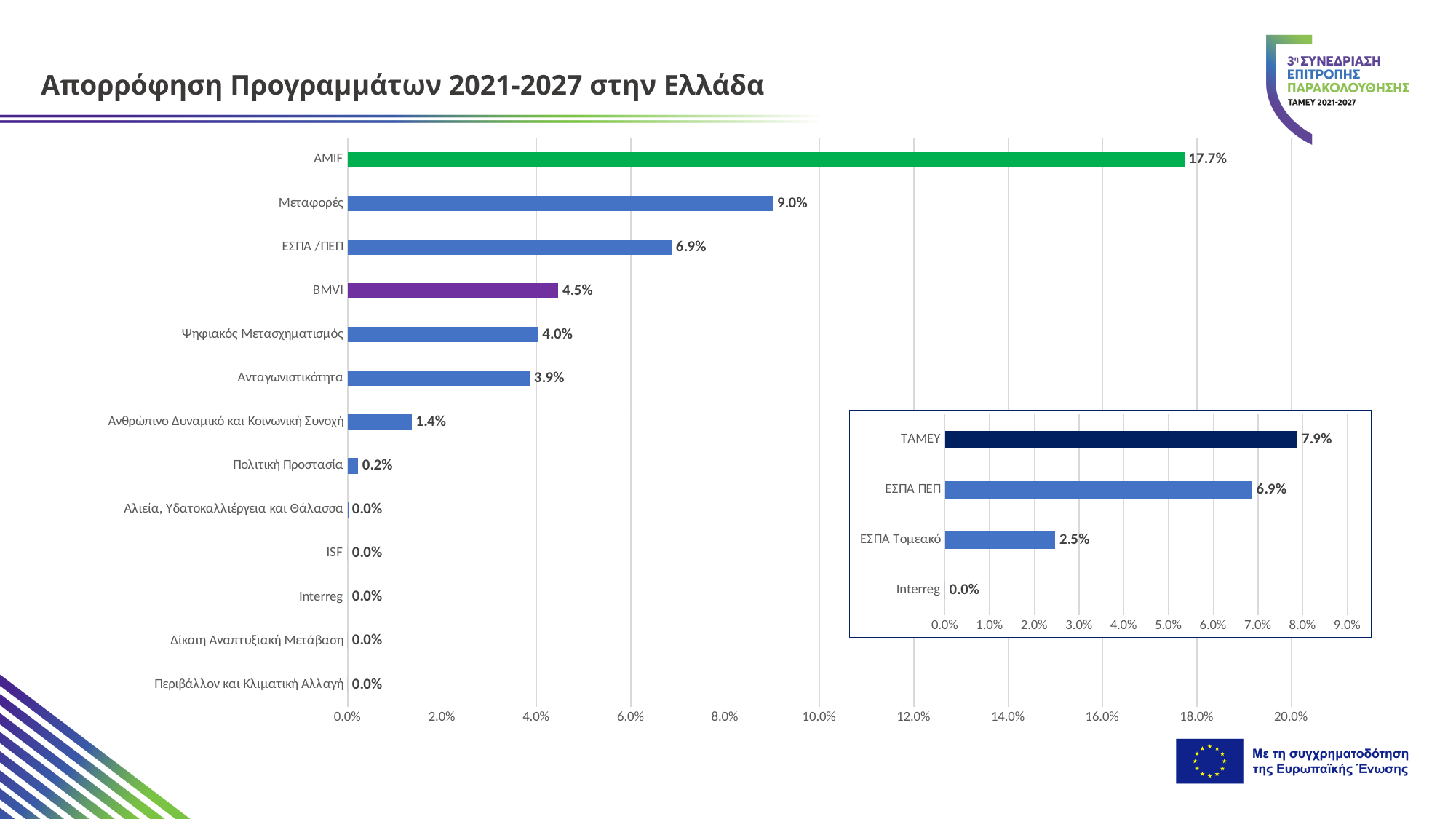
In the small inset chart on the right, what is the value for ΤΑΜΕΥ? 7.9% In the small inset chart on the right, which category has the lowest value? Interreg In the large chart on the left, what is the difference between the values for Μεταφορές and ΕΣΠΑ /ΠΕΠ? 2.1% What kind of chart is the small inset chart on the right? Bar chart In the large chart on the left, which is larger, the value for Ψηφιακός Μετασχηματισμός or the value for Ανθρώπινο Δυναμικό και Κοινωνική Συνοχή? Ψηφιακός Μετασχηματισμός In the large chart on the left, which category has the highest value? AMIF In the large chart on the left, how many categories have a value of 0.0%? 5 In the large chart on the left, what is the value for BMVI? 4.5% In the small inset chart on the right, what is the value for ΕΣΠΑ Τομεακό? 2.5% In the large chart on the left, what is the value for Μεταφορές? 9.0% In the large chart on the left, what is the value for AMIF? 17.7% In the large chart on the left, how many categories are shown? 13